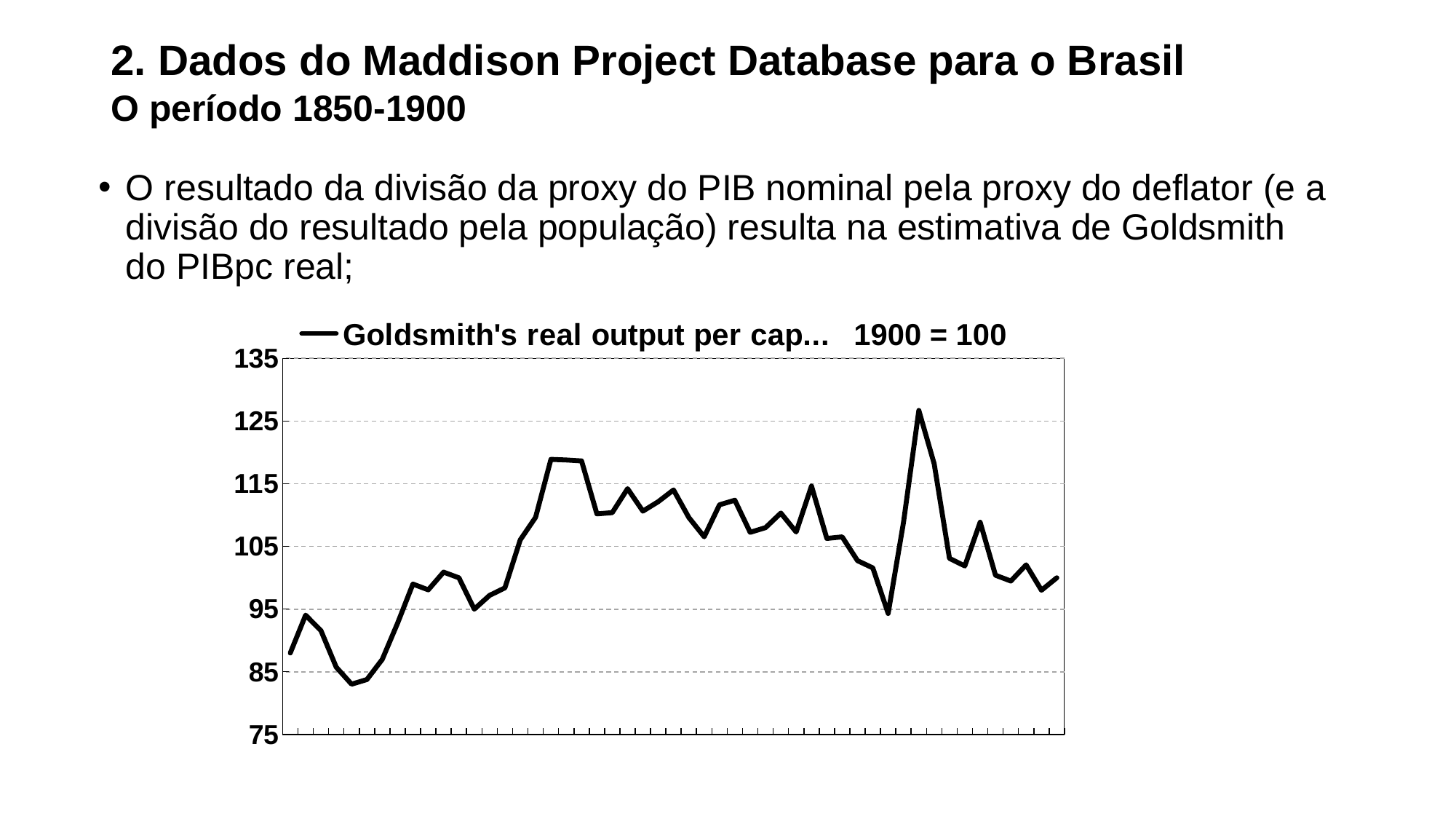
Does the line ever rise above 135? No What kind of chart is shown on the slide? line chart What is the base year index noted in the chart's legend? 1900 = 100 Is the last value of the line greater or less than 105? less Does the line overall rise or fall from its first point to its last point? rise How many series does the chart's legend list? 1 Comparing the first point and the last point of the line, which is higher? the last point What is the name of the series shown in the chart's legend? Goldsmith's real output per cap... Is the lowest value reached by the line greater or less than 85? less